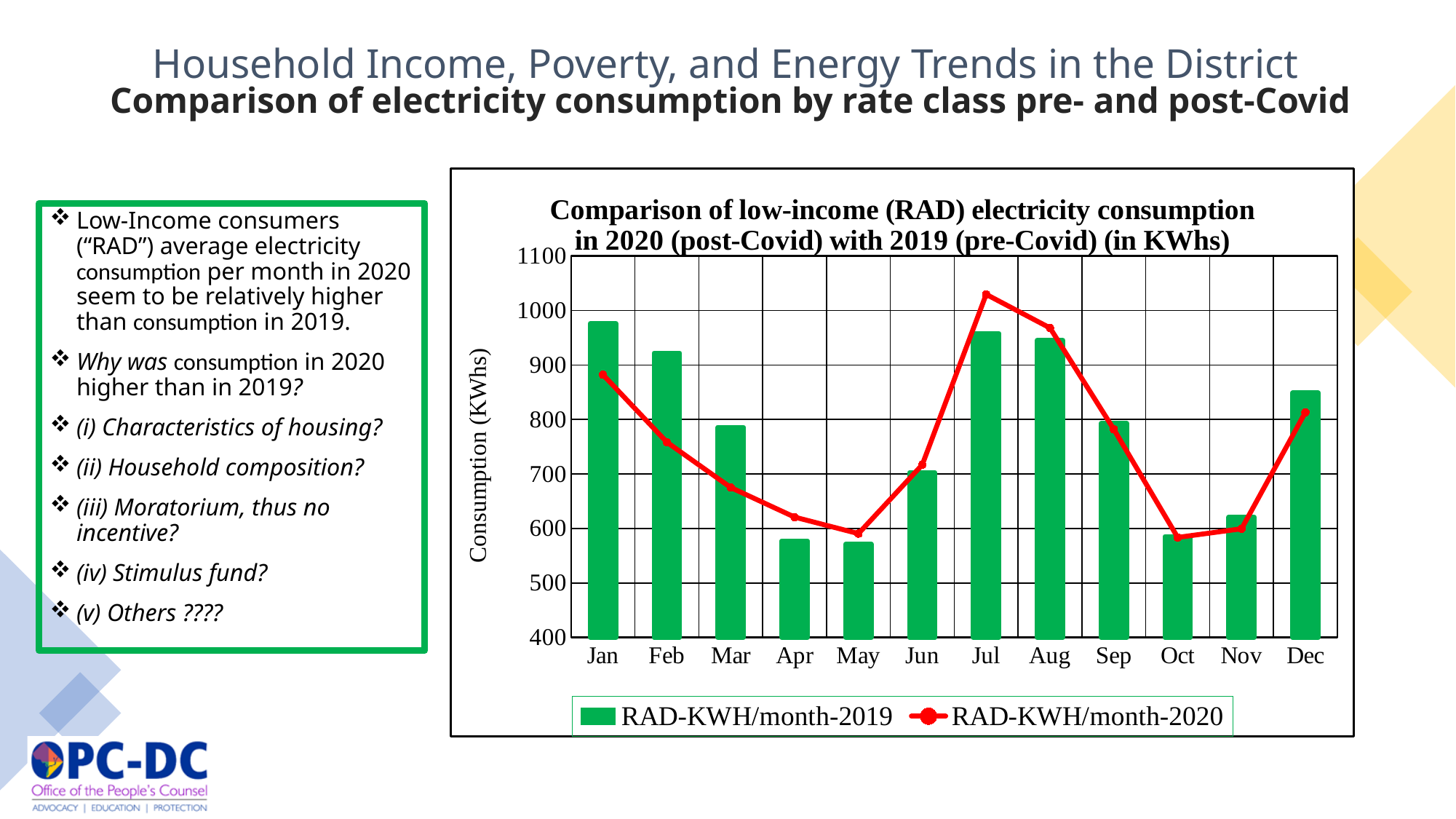
Is the RAD-KWH/month-2020 value for Feb greater or less than 800? less How many months are shown along the x axis of the chart? 12 In which month is the RAD-KWH/month-2020 value highest? Jul For Jul, which series has the larger value: RAD-KWH/month-2019 or RAD-KWH/month-2020? RAD-KWH/month-2020 How many series does the chart's legend list? 2 Does the RAD-KWH/month-2020 line rise or fall from Jan to May? fall What is the title of the chart's y axis? Consumption (KWhs) Is the RAD-KWH/month-2020 value for Jul greater or less than 1000? greater Is the RAD-KWH/month-2019 value for Apr greater or less than 600? less What kind of chart is shown on the slide? A combined bar and line chart For Jan, which series has the larger value: RAD-KWH/month-2019 or RAD-KWH/month-2020? RAD-KWH/month-2019